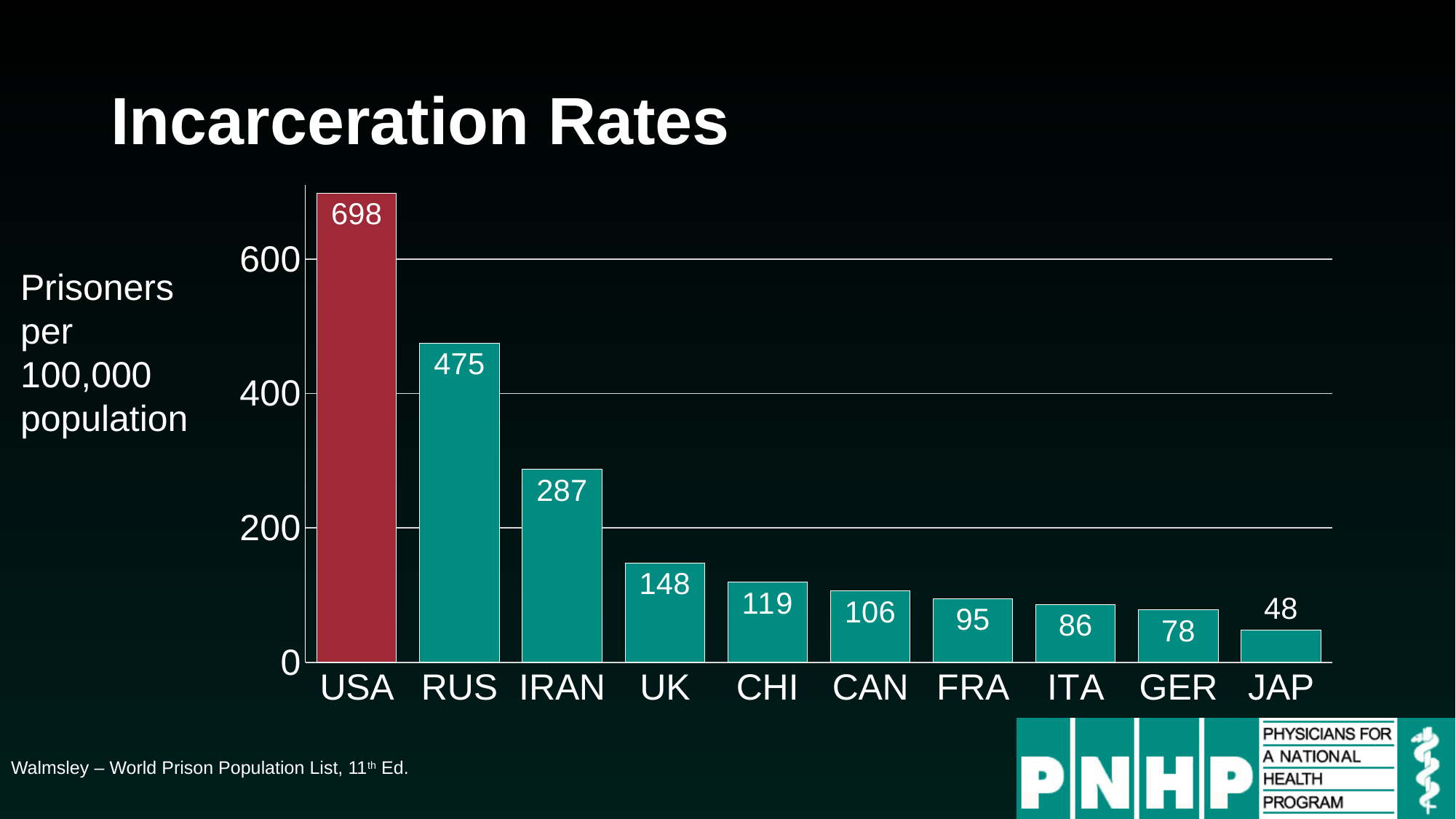
What is the value shown for RUS? 475 What is the value shown for JAP? 48 What is the difference between the values for UK and GER? 70 What kind of chart is shown on the slide? Bar chart Which country has the highest incarceration rate? USA How many countries are shown in the chart? 10 What is the difference between the values for USA and RUS? 223 What is the value shown for CAN? 106 What is the incarceration rate for the USA? 698 Which bar is coloured differently (red) from the others? USA Which country has the lowest incarceration rate? JAP Which has a higher value, IRAN or UK? IRAN